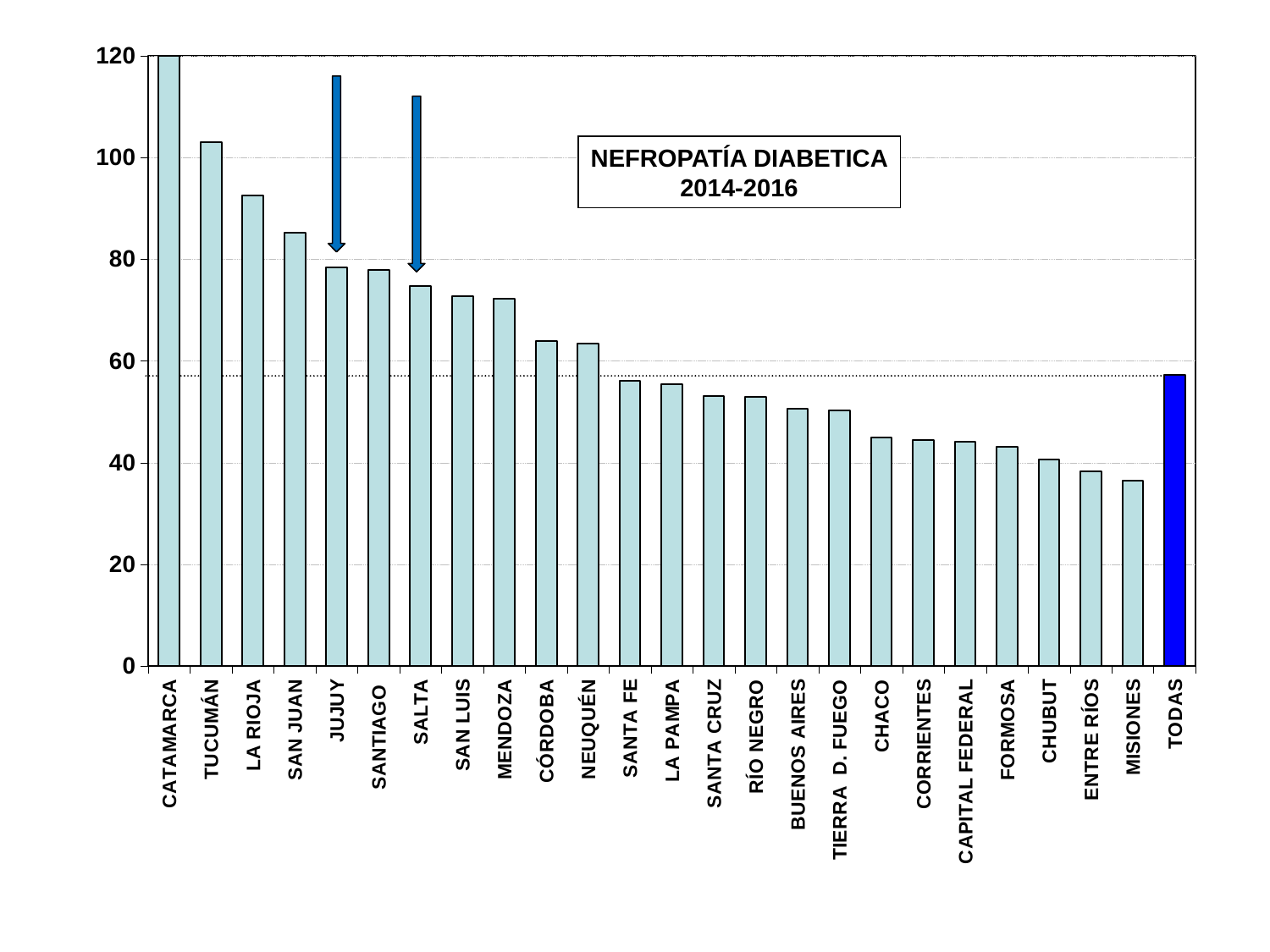
Is the value for MISIONES greater or less than 40? less Which bar is drawn in dark blue rather than light blue? TODAS Is the value for LA RIOJA greater or less than 100? less Is the value for JUJUY greater or less than 80? less Which province has the lowest bar in the chart? MISIONES Which is larger, the value for TUCUMÁN or the value for SAN JUAN? TUCUMÁN What kind of chart is shown on the slide? bar chart What is the title of the chart? NEFROPATÍA DIABETICA 2014-2016 How many bars are plotted in the chart, including TODAS? 25 Which province has the highest bar in the chart? CATAMARCA